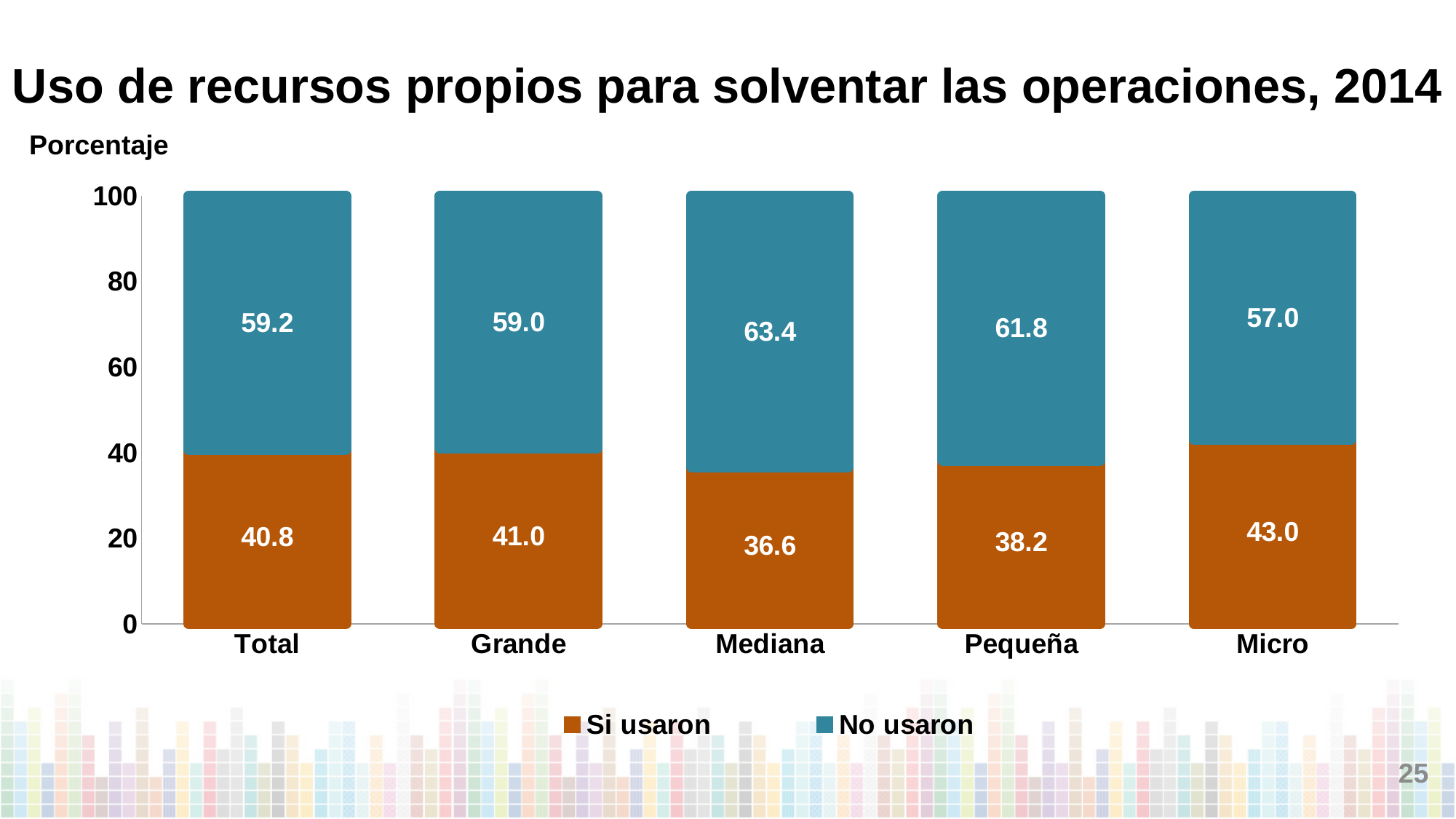
What is the title of the chart? Uso de recursos propios para solventar las operaciones, 2014 Which category has the lowest 'Si usaron' value? Mediana What is the value for 'Si usaron' in the Micro category? 43.0 What is the difference between the 'No usaron' and 'Si usaron' values for Pequeña? 23.6 What is the total of the stacked bar for Grande? 100.0 Which is larger: the 'Si usaron' value for Micro or for Grande? Micro What is the value for 'Si usaron' in the Total category? 40.8 What is the value for 'No usaron' in the Mediana category? 63.4 Which category has the highest 'No usaron' value? Mediana How many series does the legend list? 2 What kind of chart is shown on the slide? Stacked bar chart How many categories are shown on the x axis? 5